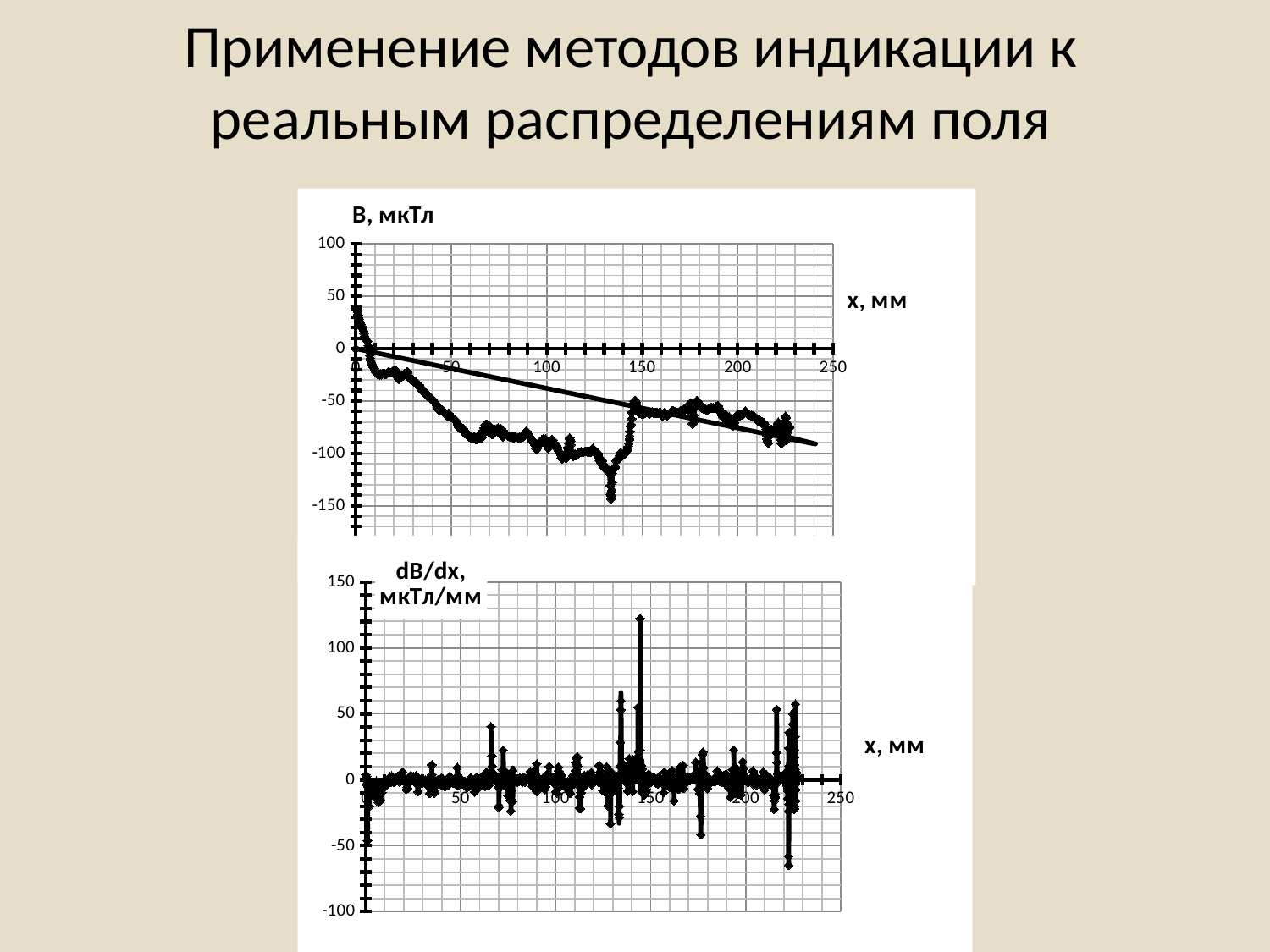
In the top chart (B, мкТл), is the value of B at x = 0 мм greater or less than 0? greater In the bottom chart (dB/dx), what is the maximum value shown on the vertical axis? 150 In the bottom chart (dB/dx), is the largest negative spike greater or less than -50? less What is the maximum value shown on the horizontal axis of both charts? 250 In the bottom chart (dB/dx), is the largest positive spike greater or less than 100? greater How many charts are shown on the slide? 2 What is the y-axis label of the top chart? B, мкТл In the top chart (B, мкТл), does the value of B overall rise or fall as x increases from 0 to 250 мм? fall In the top chart (B, мкТл), what is the highest value shown on the vertical axis? 100 What is the y-axis label of the bottom chart? dB/dx, мкТл/мм In the top chart (B, мкТл), what is the lowest value shown on the vertical axis? -150